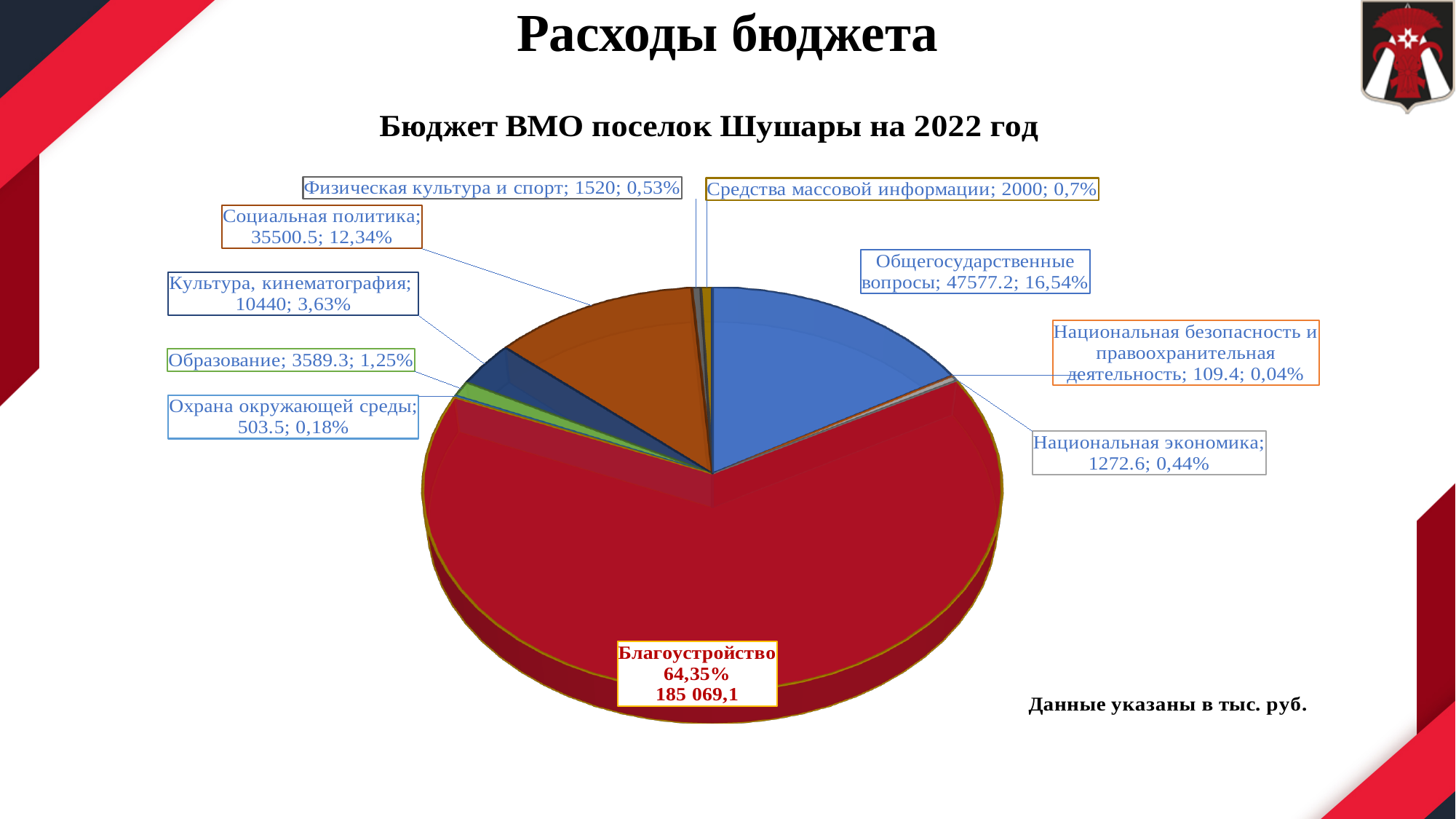
How many categories (slices) does the pie chart have? 10 What is the title of the chart? Бюджет ВМО поселок Шушары на 2022 год What is the value for Общегосударственные вопросы? 47577.2 Which category has the largest share of the budget? Благоустройство Which category has the smallest share of the budget? Национальная безопасность и правоохранительная деятельность What share of the pie does Благоустройство represent? 64,35% What is the value for Охрана окружающей среды? 503.5 What share of the pie does Культура, кинематография represent? 3,63% What is the difference between the values for Общегосударственные вопросы and Социальная политика? 12076.7 What kind of chart is shown on the slide? Pie chart What is the value for Социальная политика? 35500.5 Which is larger: the value for Средства массовой информации or Физическая культура и спорт? Средства массовой информации